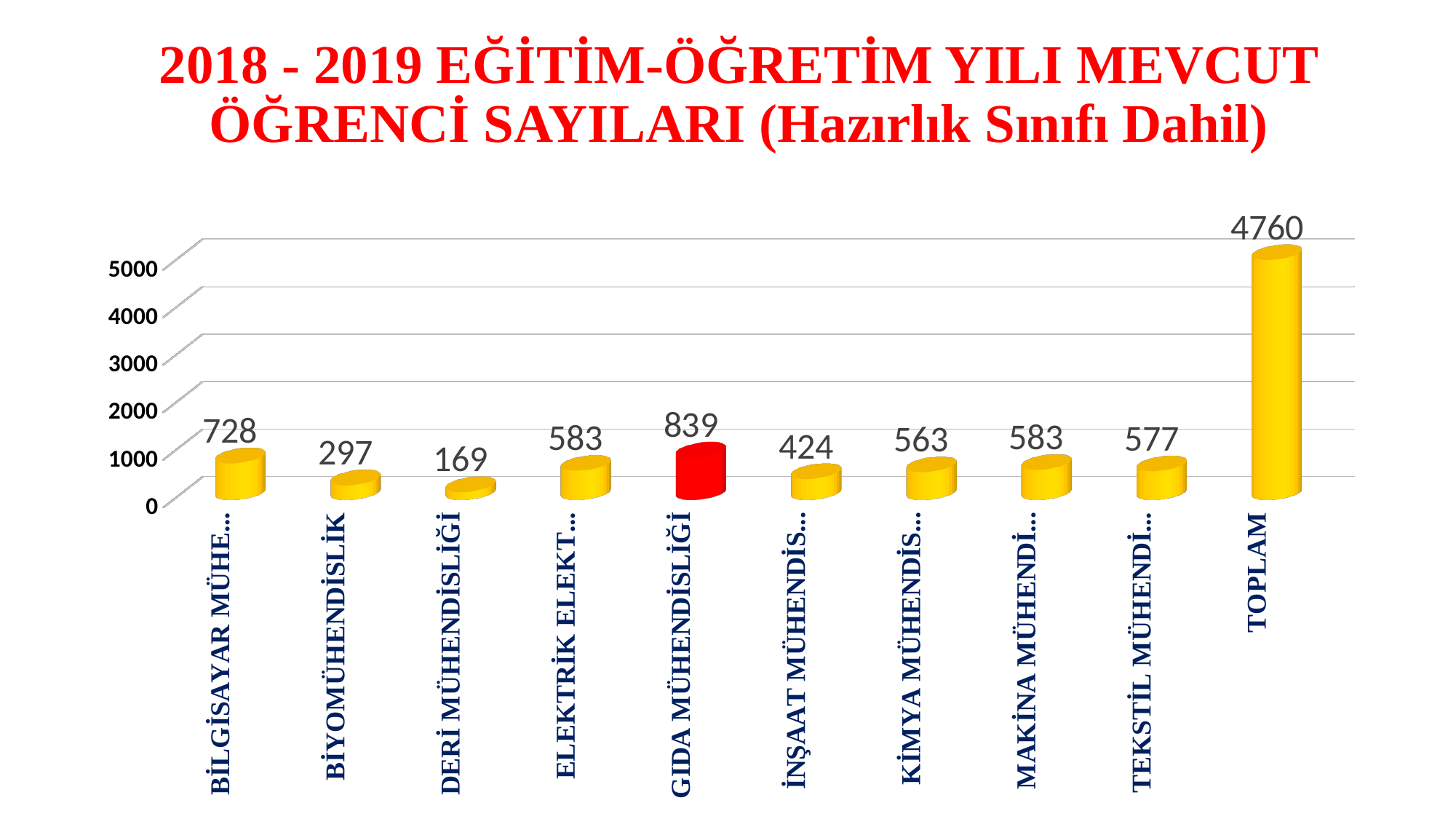
Excluding TOPLAM, which department has the highest value? GIDA MÜHENDİSLİĞİ Which category has the lowest value? DERİ MÜHENDİSLİĞİ What is the value for BİYOMÜHENDİSLİK? 297 What kind of chart is shown on the slide? bar chart Is the value for TOPLAM greater or less than 4000? greater What is the value for GIDA MÜHENDİSLİĞİ? 839 What is the value for TOPLAM? 4760 What is the value for DERİ MÜHENDİSLİĞİ? 169 What is the difference between the values for GIDA MÜHENDİSLİĞİ and DERİ MÜHENDİSLİĞİ? 670 Which is larger, the value for BİYOMÜHENDİSLİK or the value for İNŞAAT MÜHENDİS...? İNŞAAT MÜHENDİS... How many categories are shown on the x axis? 10 Which bar is coloured red instead of yellow? GIDA MÜHENDİSLİĞİ